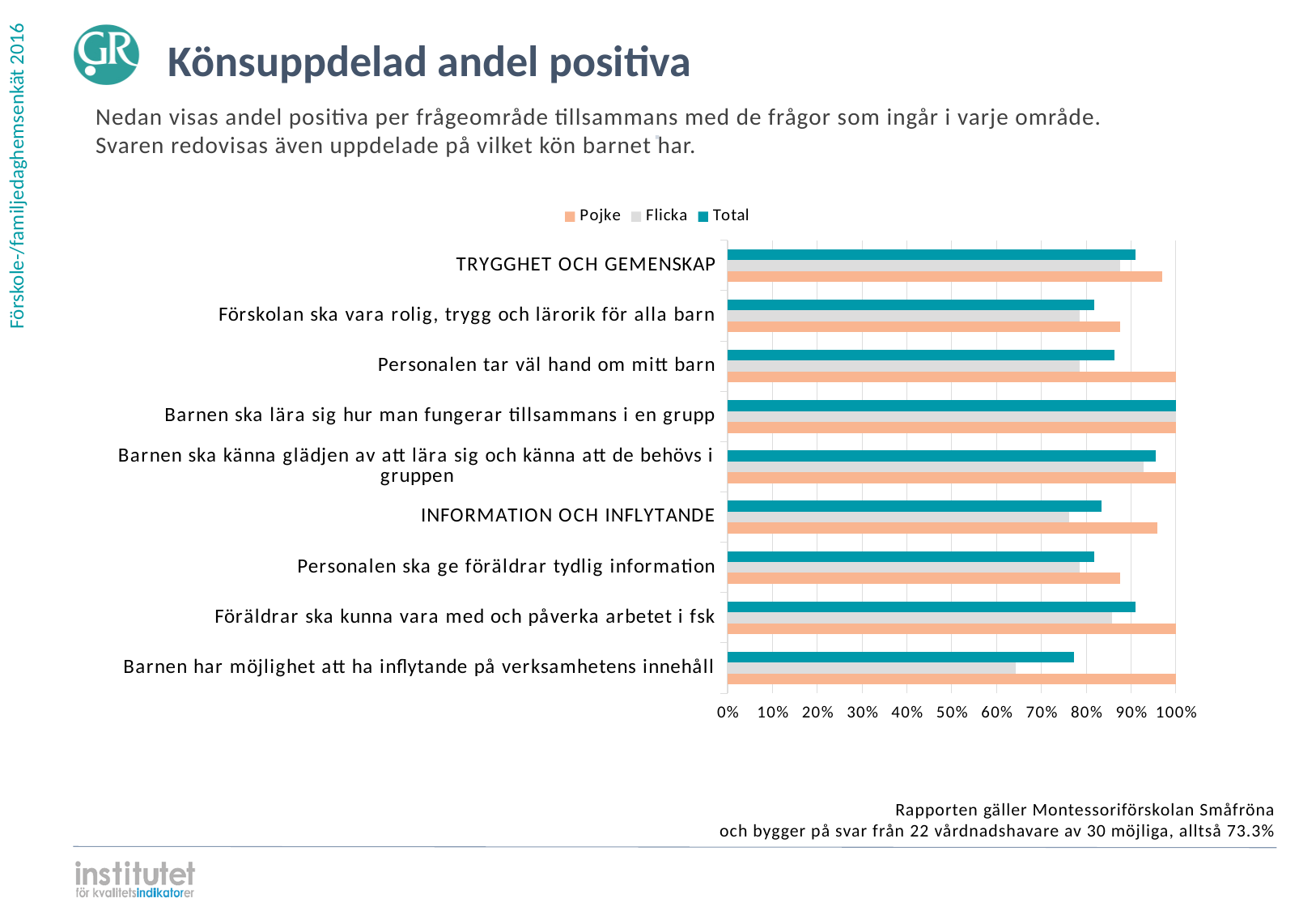
Is the Flicka value for 'Barnen har möjlighet att ha inflytande på verksamhetens innehåll' greater or less than 70%? less For 'Barnen har möjlighet att ha inflytande på verksamhetens innehåll', which is larger, the Pojke value or the Flicka value? Pojke How many series does the legend list? 3 Which category has the lowest Flicka value? Barnen har möjlighet att ha inflytande på verksamhetens innehåll Is the Flicka value for 'INFORMATION OCH INFLYTANDE' greater or less than 80%? less What is the Total value for 'Barnen ska lära sig hur man fungerar tillsammans i en grupp'? 100% Which series is shown in orange in the legend? Pojke What is the Pojke value for 'Barnen ska lära sig hur man fungerar tillsammans i en grupp'? 100% How many categories are plotted on the chart? 9 What kind of chart is shown on the slide? bar chart Is the Pojke value for 'TRYGGHET OCH GEMENSKAP' greater or less than 90%? greater What is the Pojke value for 'Personalen tar väl hand om mitt barn'? 100%